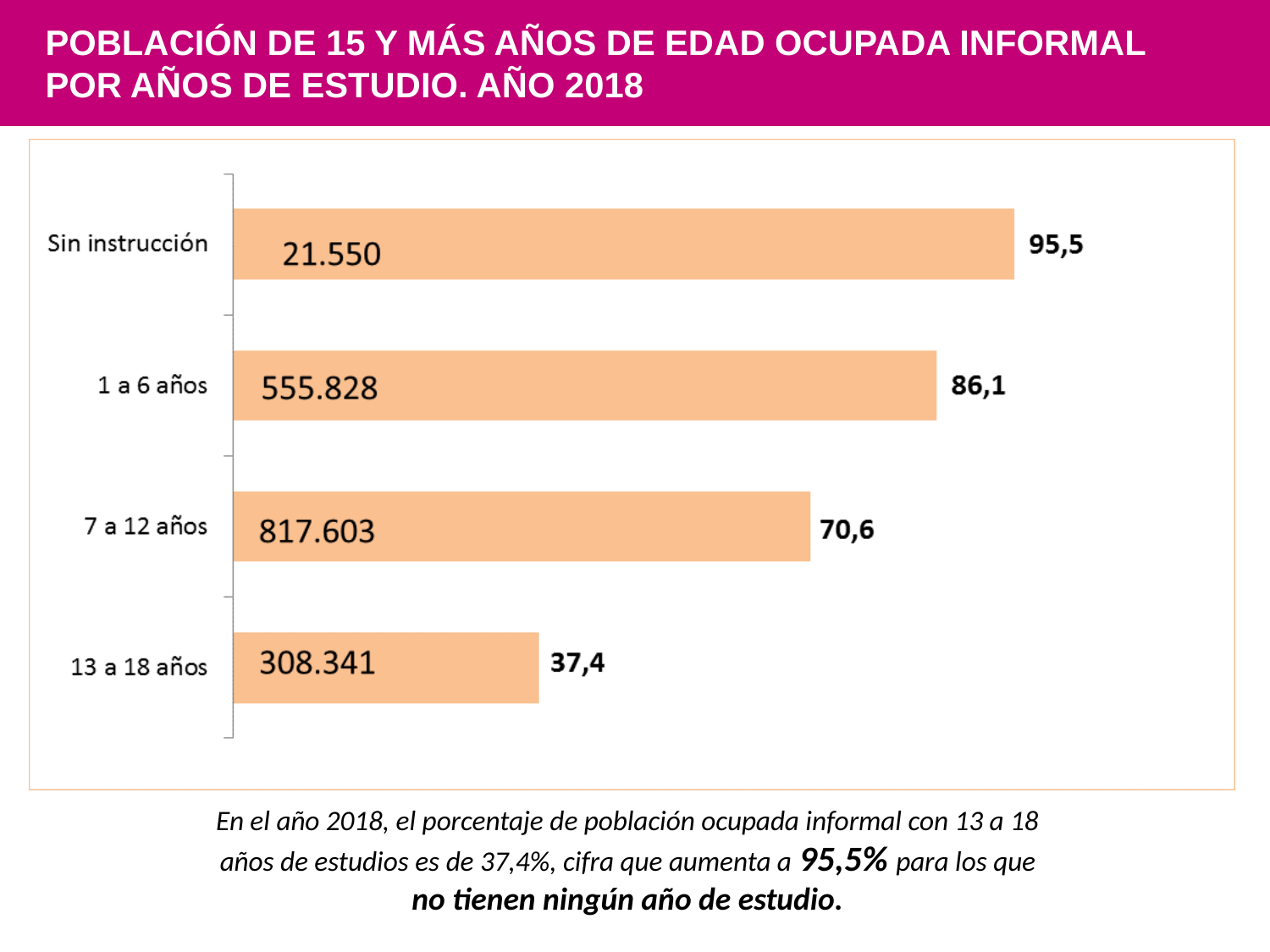
Do the percentages rise or fall as the years of study increase from 'Sin instrucción' to '13 a 18 años'? Fall How many categories are shown in the chart? 4 What is the difference in percentage between '1 a 6 años' and '7 a 12 años'? 15,5 What is the population count printed inside the bar for '7 a 12 años'? 817.603 What percentage is shown for the '13 a 18 años' category? 37,4 What is the population count printed inside the bar for '1 a 6 años'? 555.828 What is the difference in percentage between 'Sin instrucción' and '13 a 18 años'? 58,1 Which category has the highest percentage? Sin instrucción What kind of chart is shown on the slide? Bar chart Which category has the lowest percentage? 13 a 18 años Which has a higher percentage, '1 a 6 años' or '7 a 12 años'? 1 a 6 años What percentage is shown for the 'Sin instrucción' category? 95,5